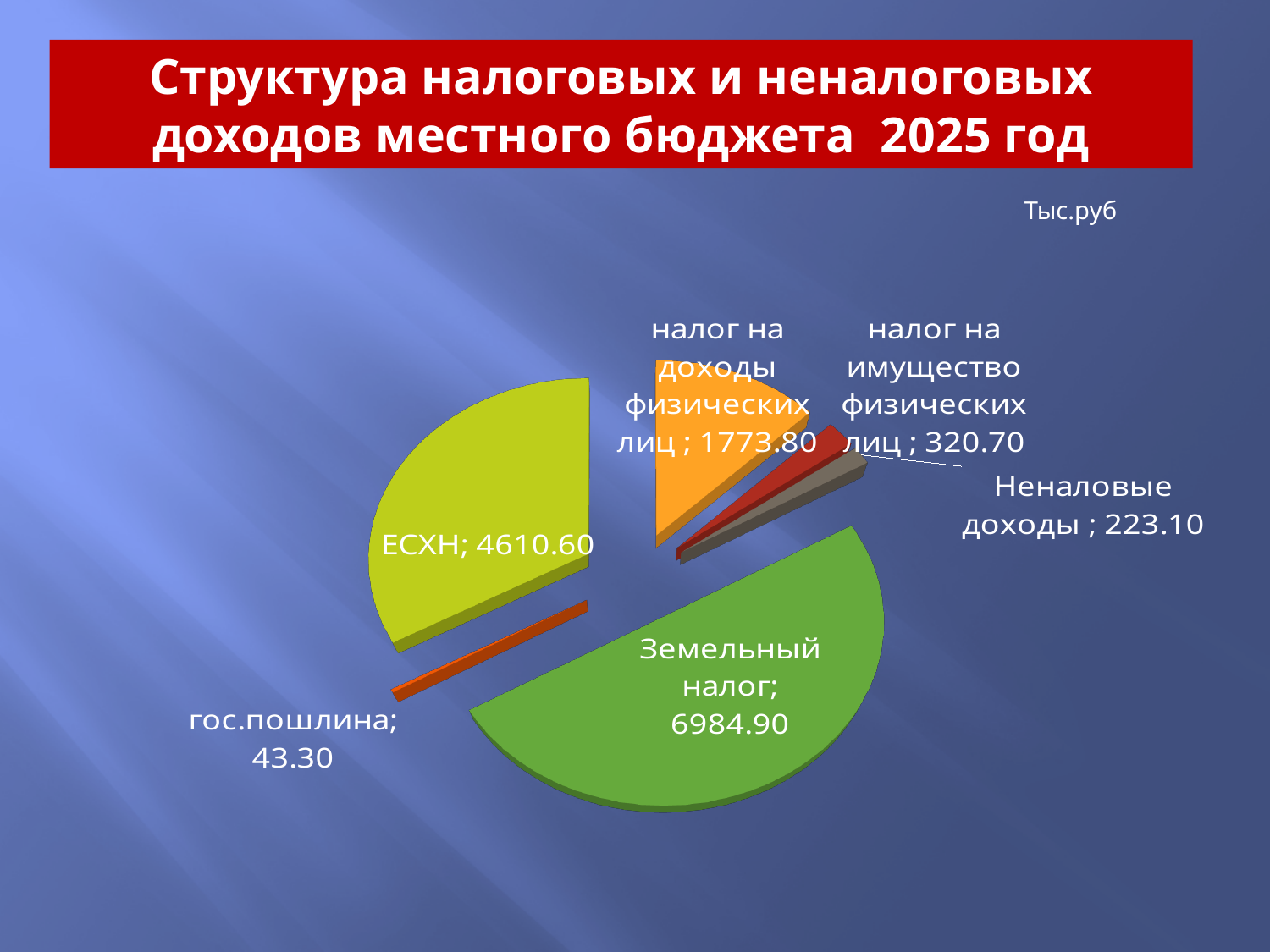
What is the value for Неналовые доходы? 223.10 Which category has the smallest value in the pie chart? гос.пошлина What is the value for гос.пошлина? 43.30 What is the difference between Земельный налог and ЕСХН? 2374.30 What kind of chart is shown on the slide? pie chart In what units are the values on the slide given? Тыс.руб What is the value for Земельный налог? 6984.90 What is the value for ЕСХН? 4610.60 How many slices does the pie chart have? 6 Which is larger: налог на имущество физических лиц or Неналовые доходы? налог на имущество физических лиц What is the value for налог на доходы физических лиц? 1773.80 Which category has the largest value in the pie chart? Земельный налог